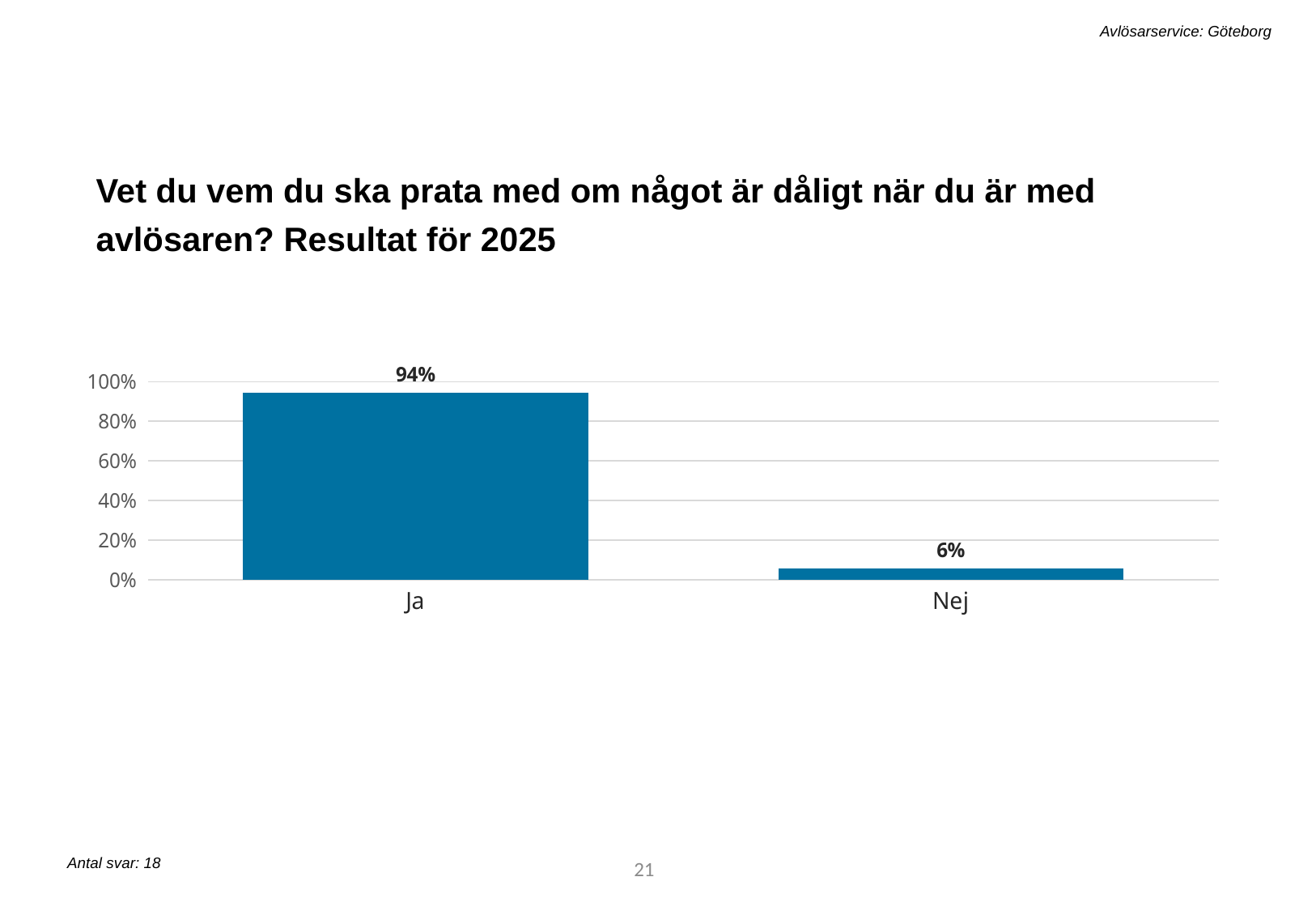
What is the difference between the values for Ja and Nej? 88% Which is larger, the value for Ja or the value for Nej? Ja What kind of chart is shown on the slide? bar chart How many categories are shown on the chart? 2 How many responses (Antal svar) does the slide report? 18 Which category has the lowest value? Nej Is the value for Ja greater or less than 80%? greater Is the value for Nej greater or less than 20%? less What is the value for Nej? 6% Which category has the highest value? Ja What is the total of the values for Ja and Nej? 100% What is the value for Ja? 94%